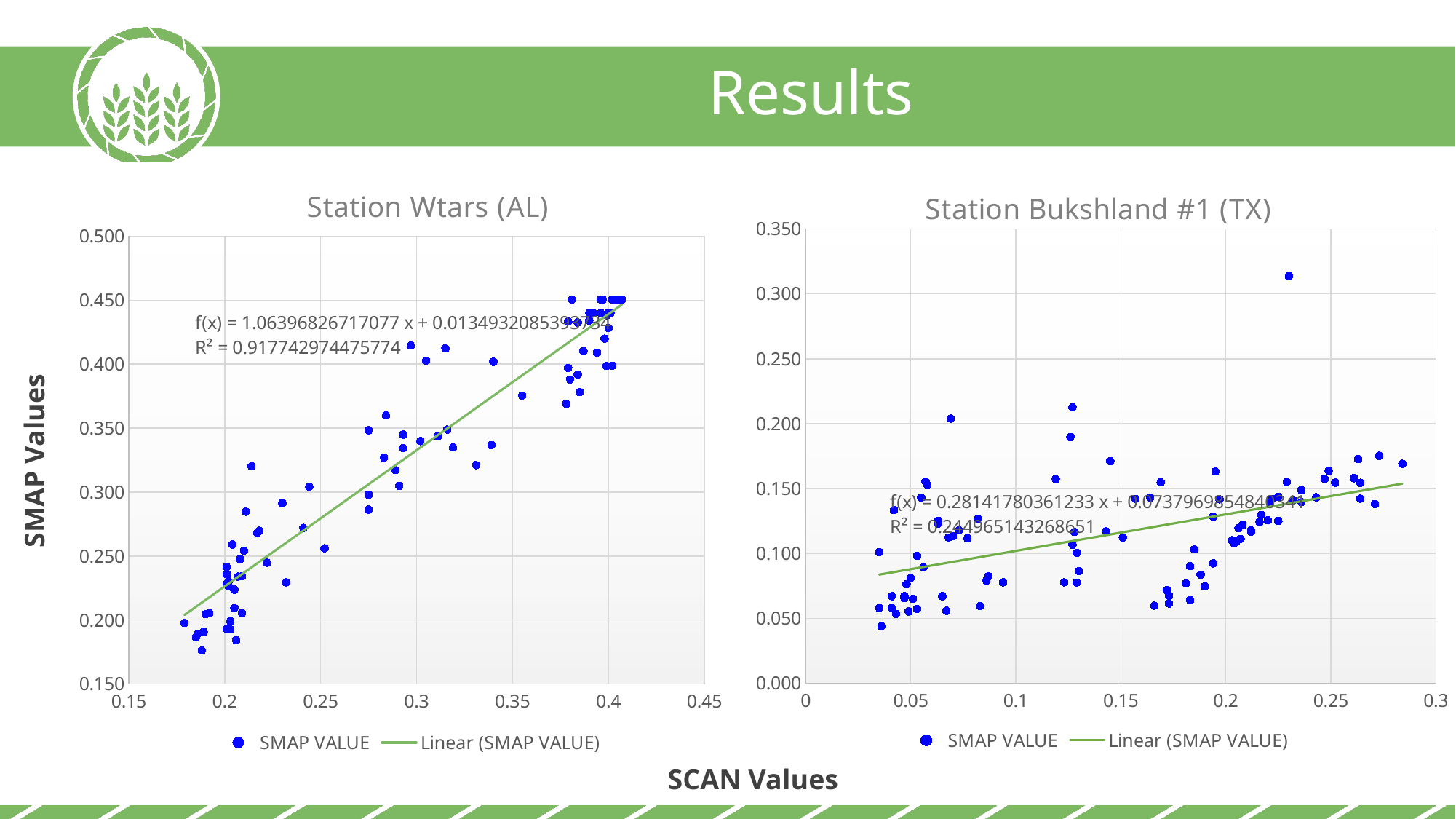
What is the title of the chart on the right side of the slide? Station Bukshland #1 (TX) In the 'Station Wtars (AL)' chart, what is the R² value shown for the linear trendline? 0.917742974475774 In the 'Station Wtars (AL)' chart, what is the slope of the linear trendline equation? 1.06396826717077 What kind of chart is the 'Station Wtars (AL)' chart? scatter chart Which chart shows the higher R² value, 'Station Wtars (AL)' or 'Station Bukshland #1 (TX)'? Station Wtars (AL) In the 'Station Wtars (AL)' chart, is the lowest plotted SMAP value greater or less than 0.200? less How many entries does the legend of the 'Station Bukshland #1 (TX)' chart list? 2 What is the label on the shared horizontal axis of the charts? SCAN Values In the 'Station Bukshland #1 (TX)' chart, what is the slope of the linear trendline equation? 0.28141780361233 In the 'Station Bukshland #1 (TX)' chart, is the highest plotted SMAP value greater or less than 0.300? greater In the 'Station Bukshland #1 (TX)' chart, does the linear trendline rise or fall along the x axis? rise In the 'Station Wtars (AL)' chart, do the SMAP values generally rise or fall as SCAN values increase? rise